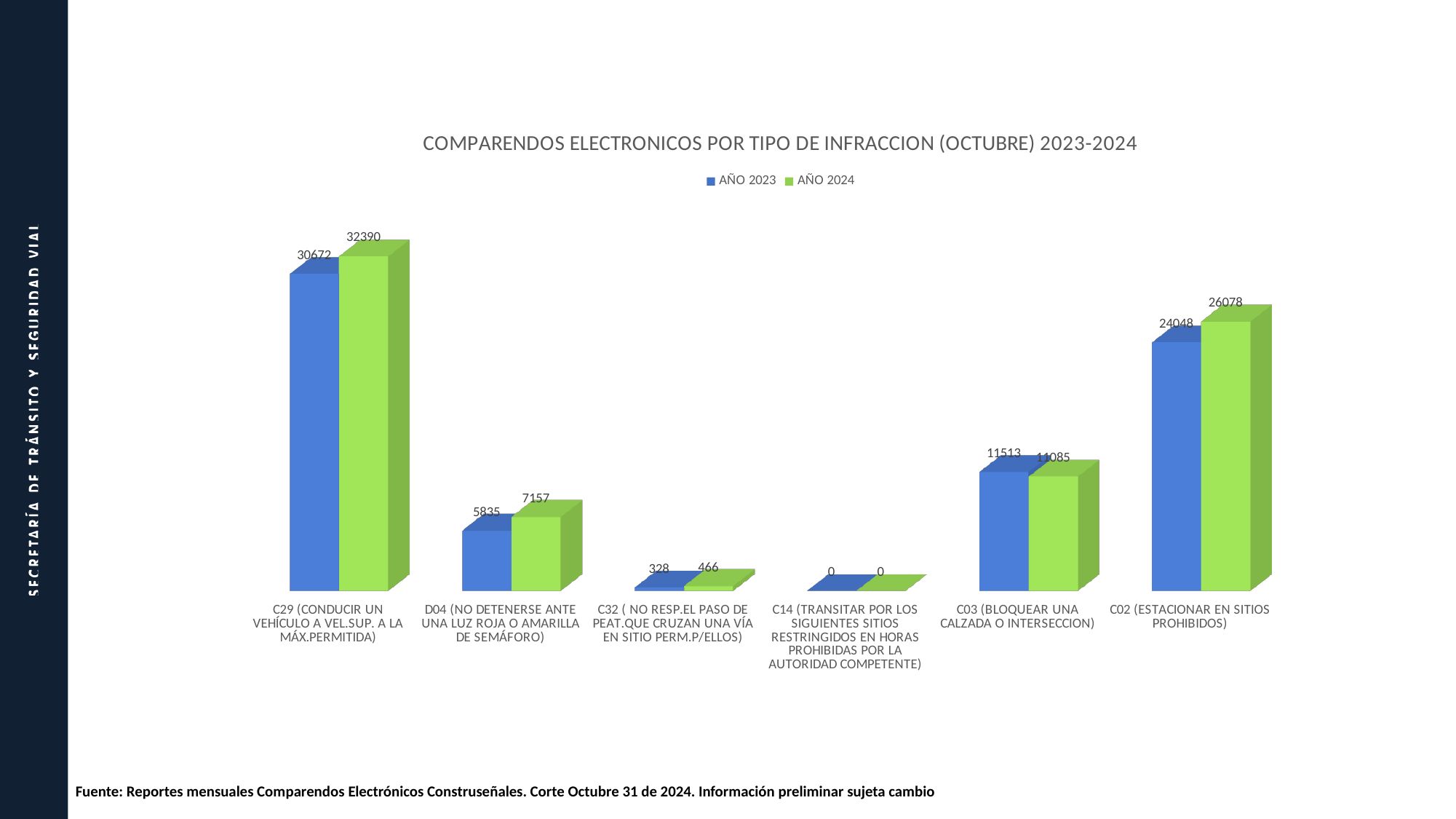
Which infraction category has the lowest AÑO 2023 value? C14 (TRANSITAR POR LOS SIGUIENTES SITIOS RESTRINGIDOS EN HORAS PROHIBIDAS POR LA AUTORIDAD COMPETENTE) For C03 (BLOQUEAR UNA CALZADA O INTERSECCION), which year has the larger value, AÑO 2023 or AÑO 2024? AÑO 2023 What is the difference between the AÑO 2024 and AÑO 2023 values for D04 (NO DETENERSE ANTE UNA LUZ ROJA O AMARILLA DE SEMÁFORO)? 1322 What is the AÑO 2024 value for C29 (CONDUCIR UN VEHÍCULO A VEL.SUP. A LA MÁX.PERMITIDA)? 32390 What is the difference between the AÑO 2024 and AÑO 2023 values for C02 (ESTACIONAR EN SITIOS PROHIBIDOS)? 2030 Which infraction category has the highest AÑO 2024 value? C29 (CONDUCIR UN VEHÍCULO A VEL.SUP. A LA MÁX.PERMITIDA) How many series does the legend list? 2 What is the AÑO 2023 value for C03 (BLOQUEAR UNA CALZADA O INTERSECCION)? 11513 What is the AÑO 2023 value for C02 (ESTACIONAR EN SITIOS PROHIBIDOS)? 24048 What kind of chart is shown on the slide? Bar chart How many infraction categories are shown on the chart? 6 For C32 ( NO RESP.EL PASO DE PEAT.QUE CRUZAN UNA VÍA EN SITIO PERM.P/ELLOS), which year has the larger value, AÑO 2023 or AÑO 2024? AÑO 2024